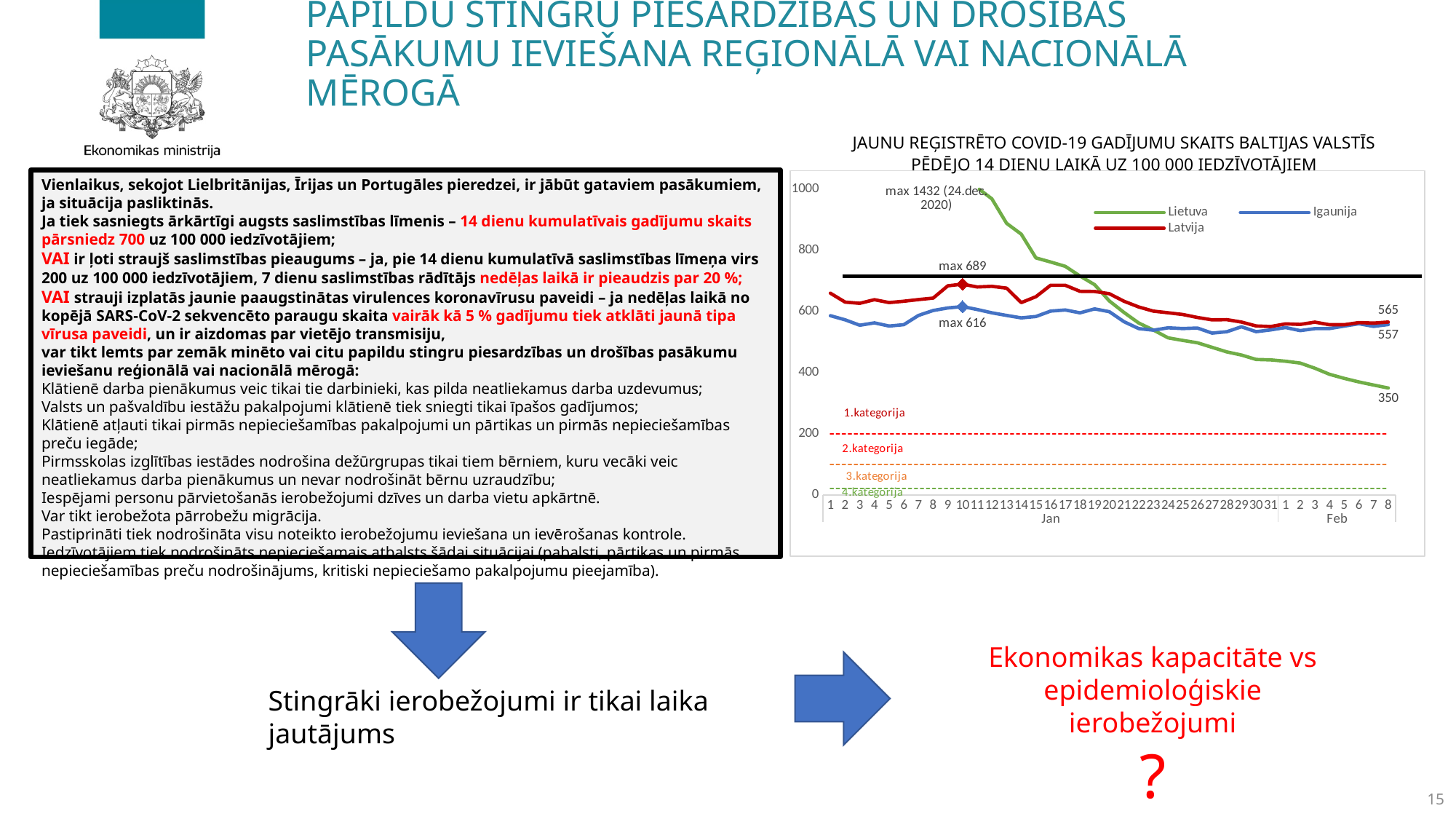
Which series has the highest labelled maximum value? Lietuva What is the maximum value labelled for Igaunija on the chart? max 616 Which countries are listed in the chart legend? Lietuva, Igaunija, Latvija What is the last labelled value for Igaunija on 8 Feb? 557 Does the Lietuva line rise or fall from the start of January to 8 February? fall How many series does the chart legend list? 3 What kind of chart is shown on the slide? line chart What is the difference between the final values of Latvija (565) and Igaunija (557)? 8 What is the last labelled value for Latvija on 8 Feb? 565 What is the last labelled value for Lietuva on 8 Feb? 350 What is the maximum value labelled for Lietuva on the chart? max 1432 (24.dec. 2020) What is the maximum value labelled for Latvija on the chart? max 689